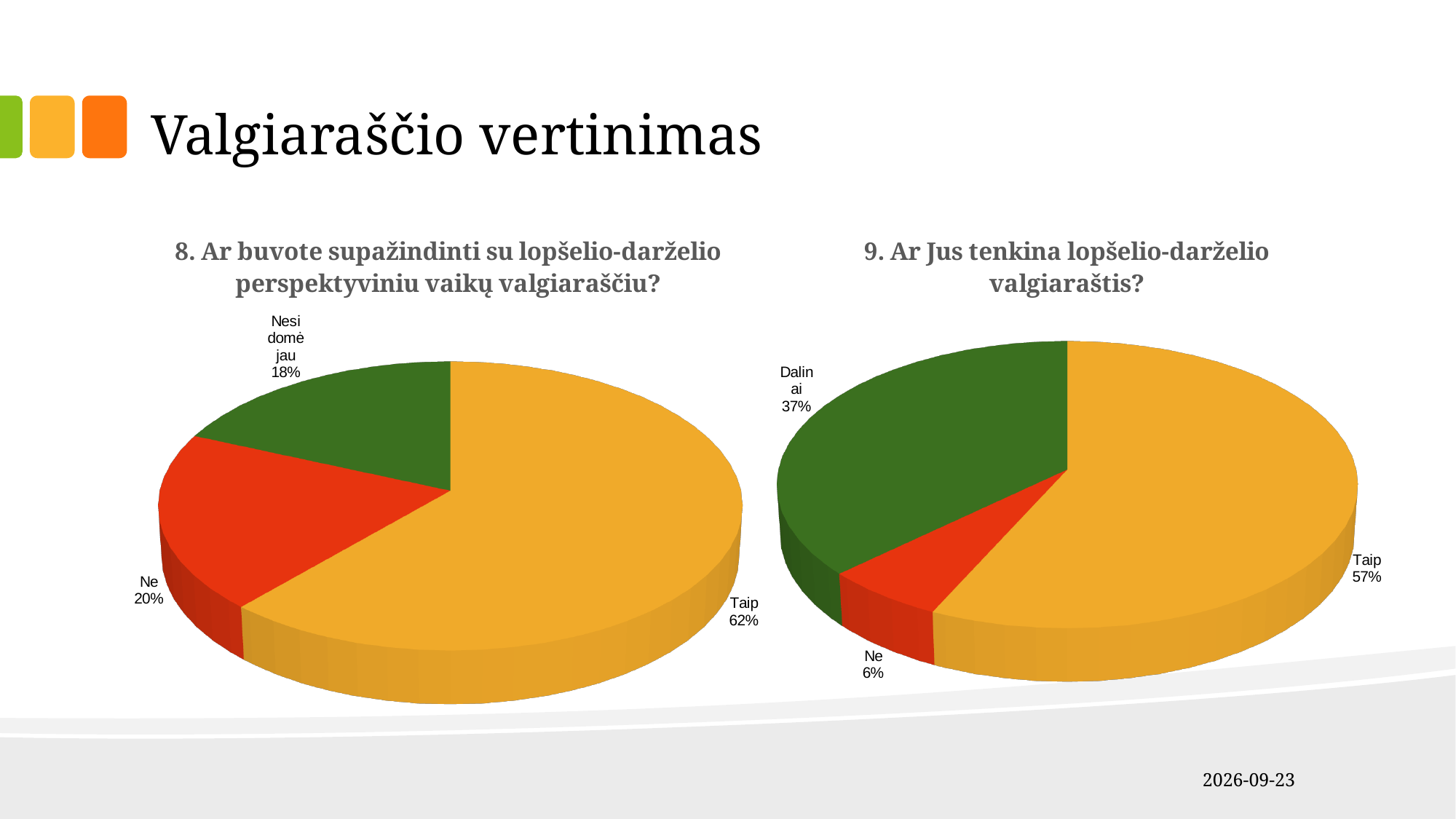
In the left chart (question 8), which is larger: the share for "Ne" or the share for "Nesidomėjau"? Ne In the left chart (question 8), what share of respondents answered "Taip"? 62% In the right chart (question 9), what share of respondents answered "Ne"? 6% What colour is the "Taip" slice in the right chart (question 9)? Orange In the left chart (question 8), what share of respondents answered "Ne"? 20% What type of chart is used on the left (question 8)? Pie chart In the left chart (question 8), what share of respondents answered "Nesidomėjau"? 18% In the right chart (question 9), which answer has the smallest share? Ne In the right chart (question 9), what is the difference in percentage points between "Taip" and "Dalinai"? 20 How many slices does the right chart (question 9) have? 3 In the left chart (question 8), which answer has the largest share? Taip In the right chart (question 9), what share of respondents answered "Dalinai"? 37%